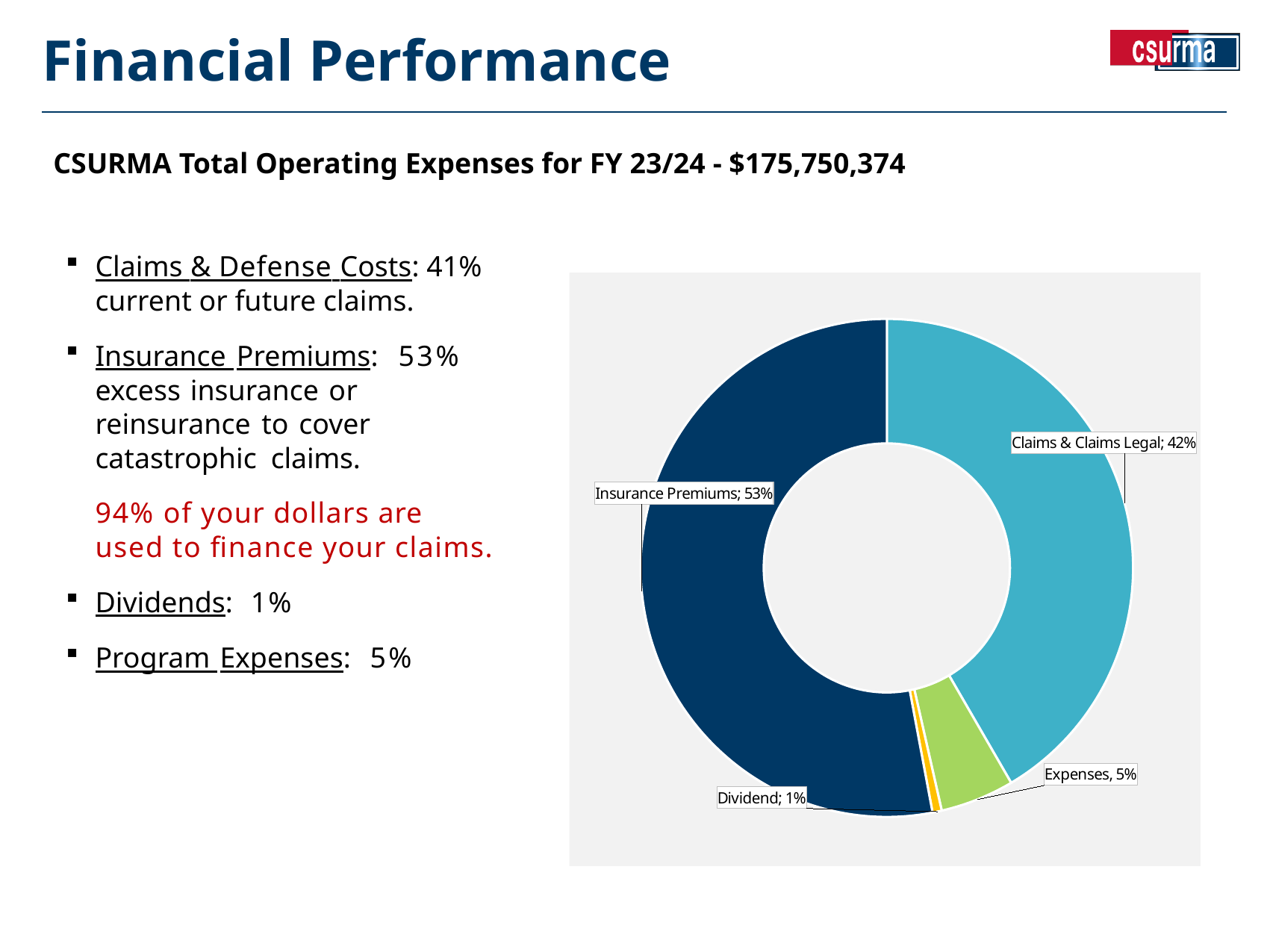
What is the difference in percentage points between Insurance Premiums and Claims & Claims Legal in the chart? 11 Which category has the smallest slice in the chart? Dividend What is the combined share of Insurance Premiums and Claims & Claims Legal in the chart? 95% What percentage does the chart show for Claims & Claims Legal? 42% What percentage does the chart show for Dividend? 1% Which category has the largest slice in the chart? Insurance Premiums Which is larger in the chart, Expenses or Dividend? Expenses What percentage does the chart show for Expenses? 5% How many slices does the chart have? 4 What colour is the Expenses slice in the chart? Green What share of the doughnut chart is labelled for Insurance Premiums? 53% What kind of chart is shown on the slide? Doughnut (pie) chart